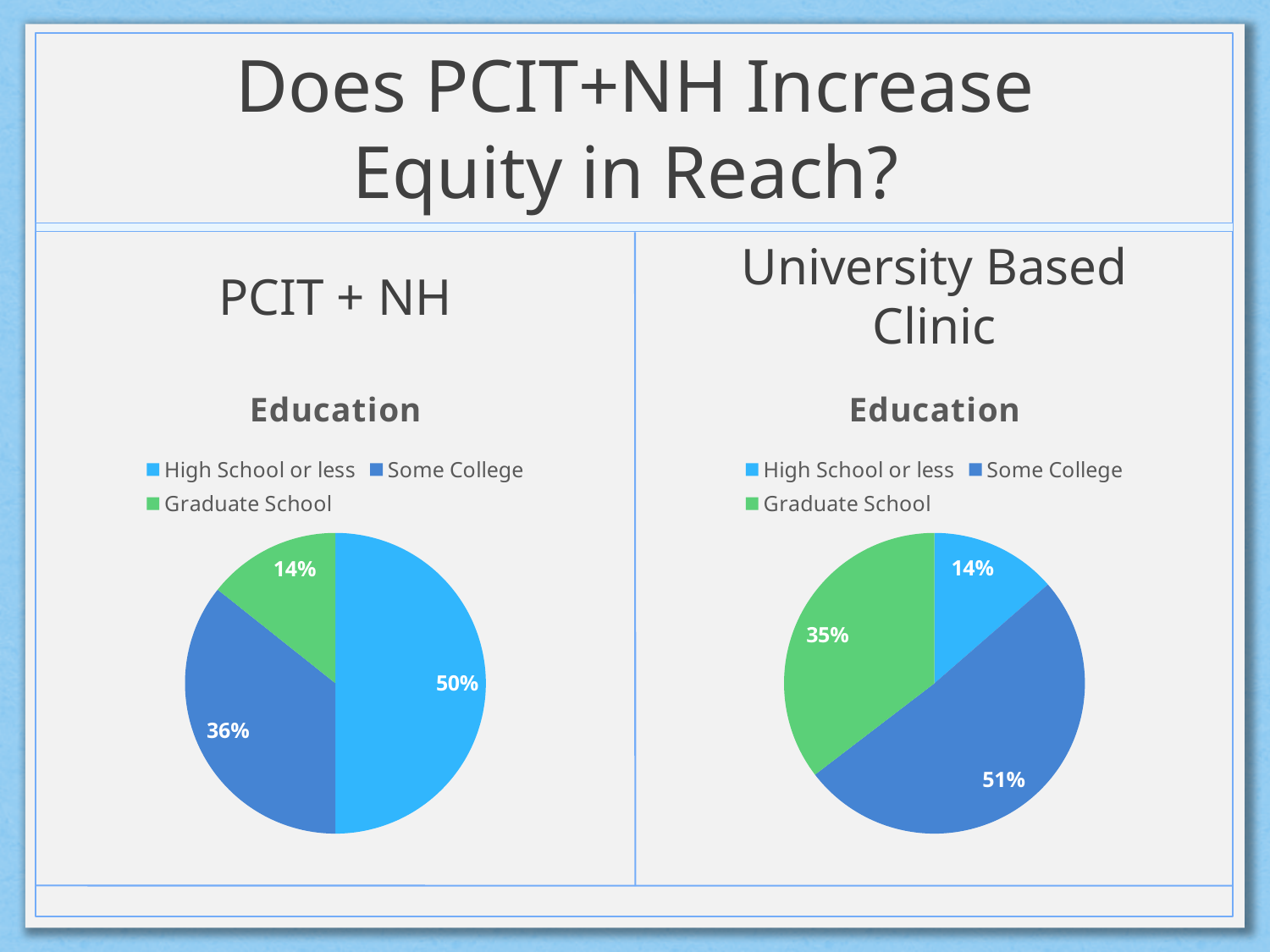
How many slices does the PCIT + NH pie chart on the left have? 3 In the University Based Clinic pie chart on the right, which is larger: Some College or Graduate School? Some College What is the title of the pie chart on the right under University Based Clinic? Education In the PCIT + NH pie chart on the left, what is the difference between the High School or less share and the Graduate School share? 36% In the University Based Clinic pie chart on the right, which category has the smallest share? High School or less What type of chart is used on the left side of the slide for PCIT + NH? Pie chart In the University Based Clinic pie chart on the right, what percentage is High School or less? 14% In the PCIT + NH pie chart on the left, which category has the largest share? High School or less In the PCIT + NH pie chart on the left, what percentage is High School or less? 50% In the PCIT + NH pie chart on the left, what percentage is Some College? 36% In the University Based Clinic pie chart on the right, what percentage is Graduate School? 35% How many entries does the legend of the University Based Clinic chart on the right list? 3